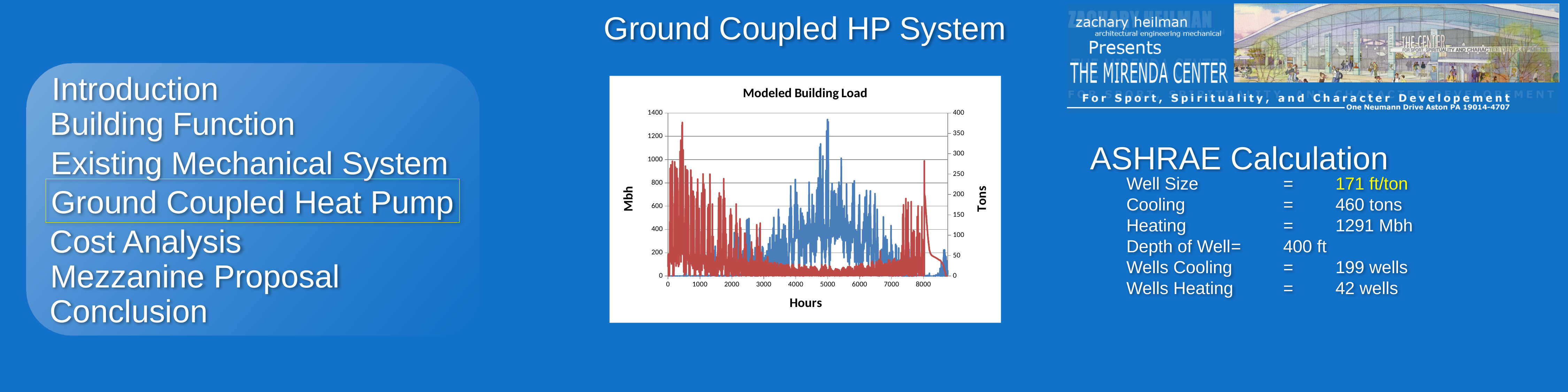
In the Modeled Building Load chart, is the highest peak of the red series greater or less than 1200 on the Mbh axis? greater In the Modeled Building Load chart, does the highest peak of the blue series occur at greater or less than 4000 hours? greater What kind of chart is the Modeled Building Load chart? line chart What is the label of the x axis of the Modeled Building Load chart? Hours How many data series are plotted in the Modeled Building Load chart? 2 In the Modeled Building Load chart, which series is higher around 500 hours, the red or the blue? red What is the title of the chart on the slide? Modeled Building Load In the Modeled Building Load chart, does the highest peak of the red series occur at greater or less than 1000 hours? less In the Modeled Building Load chart, which series is higher around 5000 hours, the red or the blue? blue